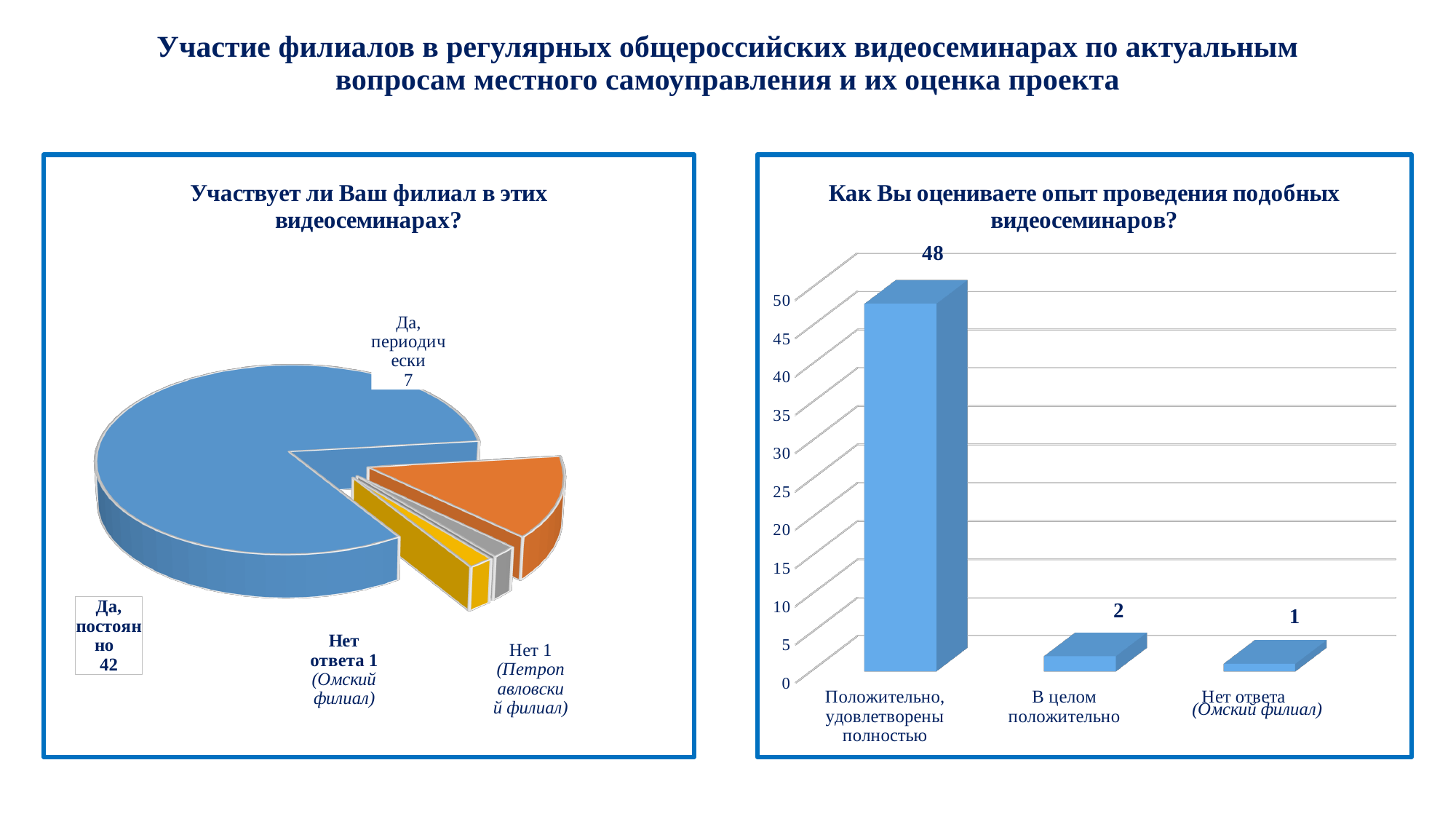
In the pie chart on the left, how many categories are shown? 4 In the pie chart on the left, what is the value for "Да, периодически"? 7 In the bar chart on the right, what is the value for "В целом положительно"? 2 In the bar chart on the right, do the values rise or fall from left to right? Fall In the bar chart on the right, which category has the lowest value? Нет ответа (Омский филиал) In the bar chart on the right, what is the difference between "Положительно, удовлетворены полностью" and "В целом положительно"? 46 In the pie chart on the left, how many branches answered "Да, постоянно"? 42 What type of chart is shown on the right side of the slide? Bar chart In the pie chart on the left, which category has the largest slice? Да, постоянно In the pie chart on the left, what is the difference between "Да, постоянно" and "Да, периодически"? 35 In the pie chart on the left, what is the total of all slices? 51 In the bar chart on the right, what is the value for "Положительно, удовлетворены полностью"? 48